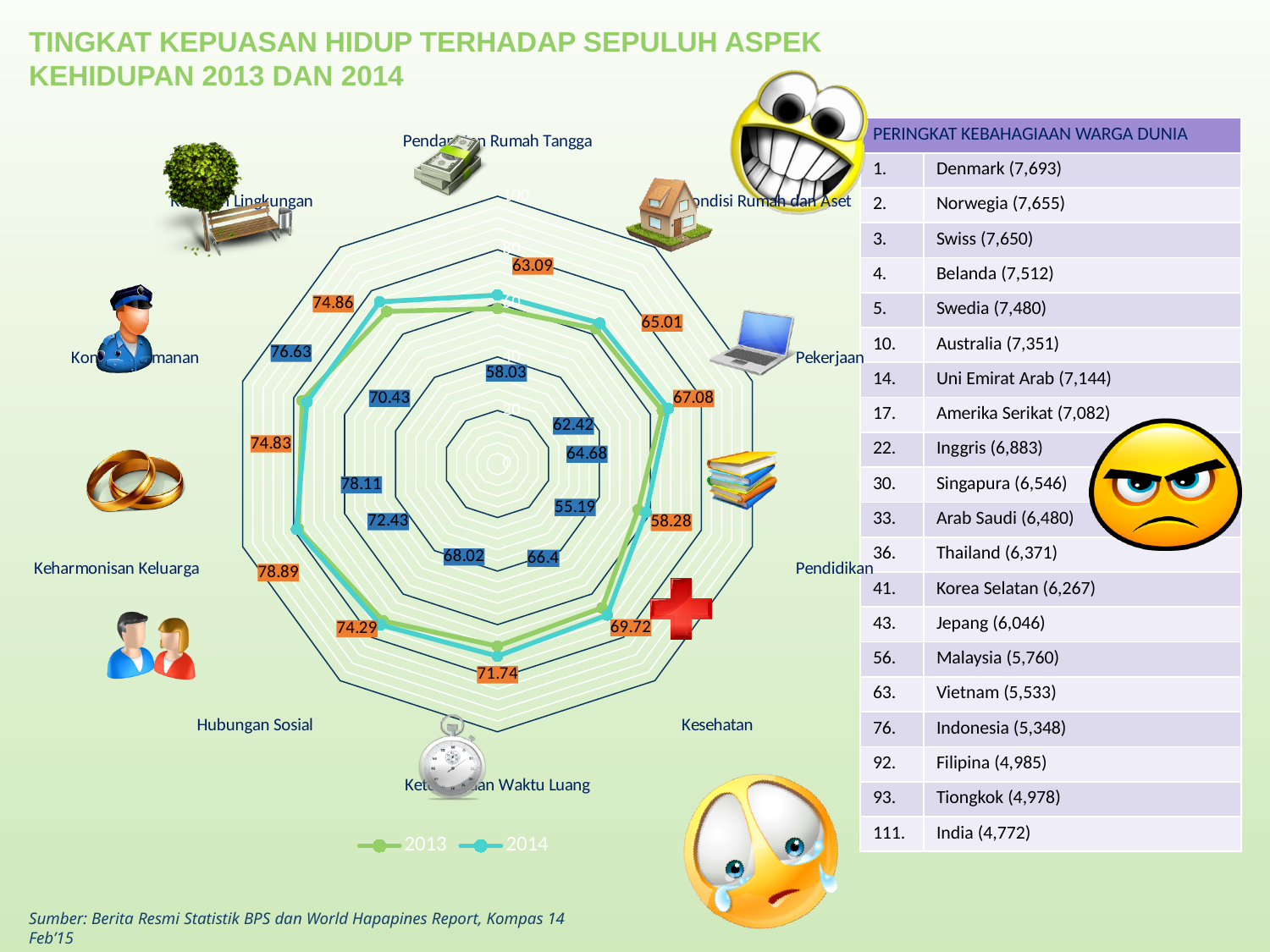
What is the 2014 value for Pekerjaan? 67.08 What is the 2013 value for Kesehatan? 66.4 Which years are listed in the chart legend? 2013 and 2014 Which aspect has the highest 2014 value? Keharmonisan Keluarga Which aspect has the lowest 2014 value? Pendidikan What kind of chart is shown on the slide? Radar chart What is the 2013 value for Pendidikan? 55.19 How many series does the chart legend list? 2 How many aspects (categories) are plotted on the radar chart? 10 Which has the larger 2014 value, Kesehatan or Pekerjaan? Kesehatan What is the 2014 value for Kesehatan? 69.72 What is the difference between the 2014 and 2013 values for Kesehatan? 3.32